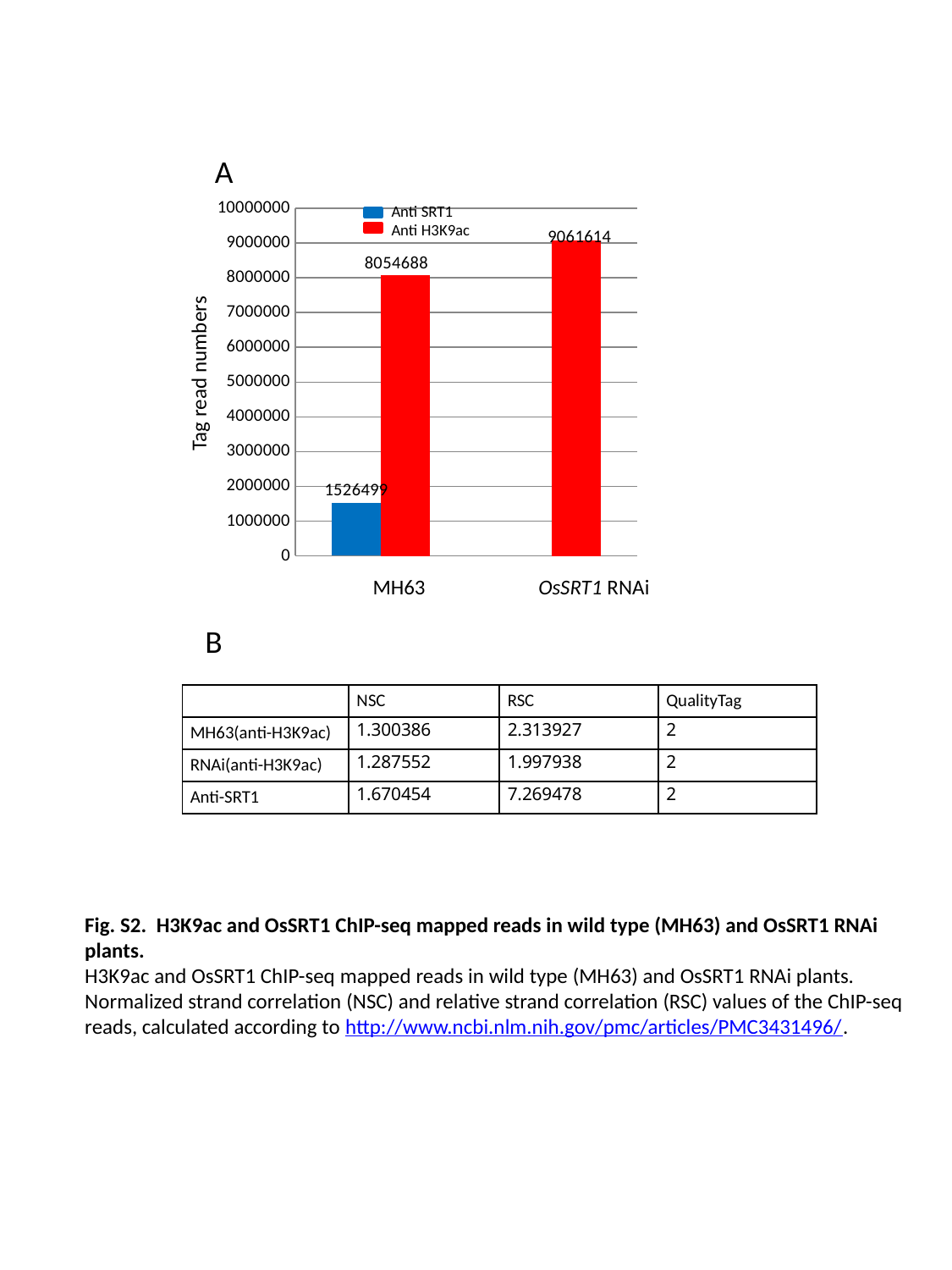
What is the Anti SRT1 tag read number for MH63? 1526499 What kind of chart is shown in panel A? bar chart What is the Anti H3K9ac tag read number for MH63? 8054688 What is the difference between the Anti H3K9ac and Anti SRT1 tag read numbers for MH63? 6528189 Which bar in the chart has the highest tag read number? Anti H3K9ac for OsSRT1 RNAi What is the difference between the Anti H3K9ac tag read numbers for OsSRT1 RNAi and MH63? 1006926 How many series does the chart legend list? 2 What is the Anti H3K9ac tag read number for OsSRT1 RNAi? 9061614 What is the label of the y axis in the chart? Tag read numbers Is the Anti SRT1 value for MH63 greater or less than 2000000? less Which bar in the chart has the lowest tag read number? Anti SRT1 for MH63 Which is larger for MH63: the Anti SRT1 or the Anti H3K9ac tag read number? Anti H3K9ac